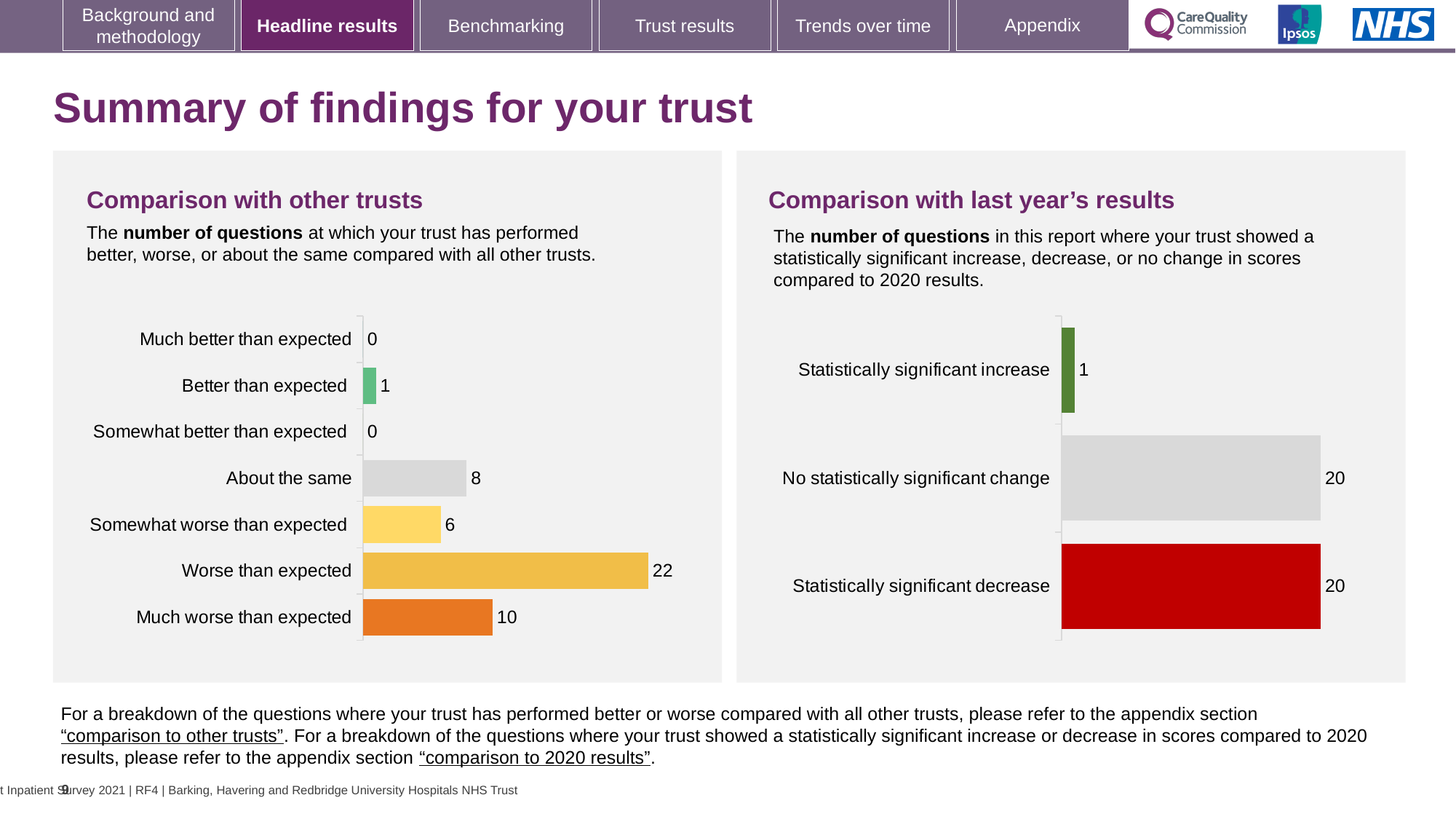
How many categories are shown in the 'Comparison with other trusts' chart? 7 In the 'Comparison with last year's results' chart, what is the difference between 'No statistically significant change' and 'Statistically significant increase'? 19 In the 'Comparison with other trusts' chart, what is the difference between 'Worse than expected' and 'Much worse than expected'? 12 In the 'Comparison with other trusts' chart, how many questions were 'About the same'? 8 What type of chart is the 'Comparison with last year's results' chart? Bar chart In the 'Comparison with other trusts' chart, how many questions were 'Worse than expected'? 22 In the 'Comparison with last year's results' chart, what colour is the 'Statistically significant decrease' bar? Red In the 'Comparison with other trusts' chart, which is larger: 'Somewhat worse than expected' or 'About the same'? About the same In the 'Comparison with last year's results' chart, how many questions showed a statistically significant decrease? 20 In the 'Comparison with other trusts' chart, how many questions were 'Better than expected'? 1 In the 'Comparison with other trusts' chart, which category has the highest value? Worse than expected In the 'Comparison with last year's results' chart, which category has the lowest value? Statistically significant increase